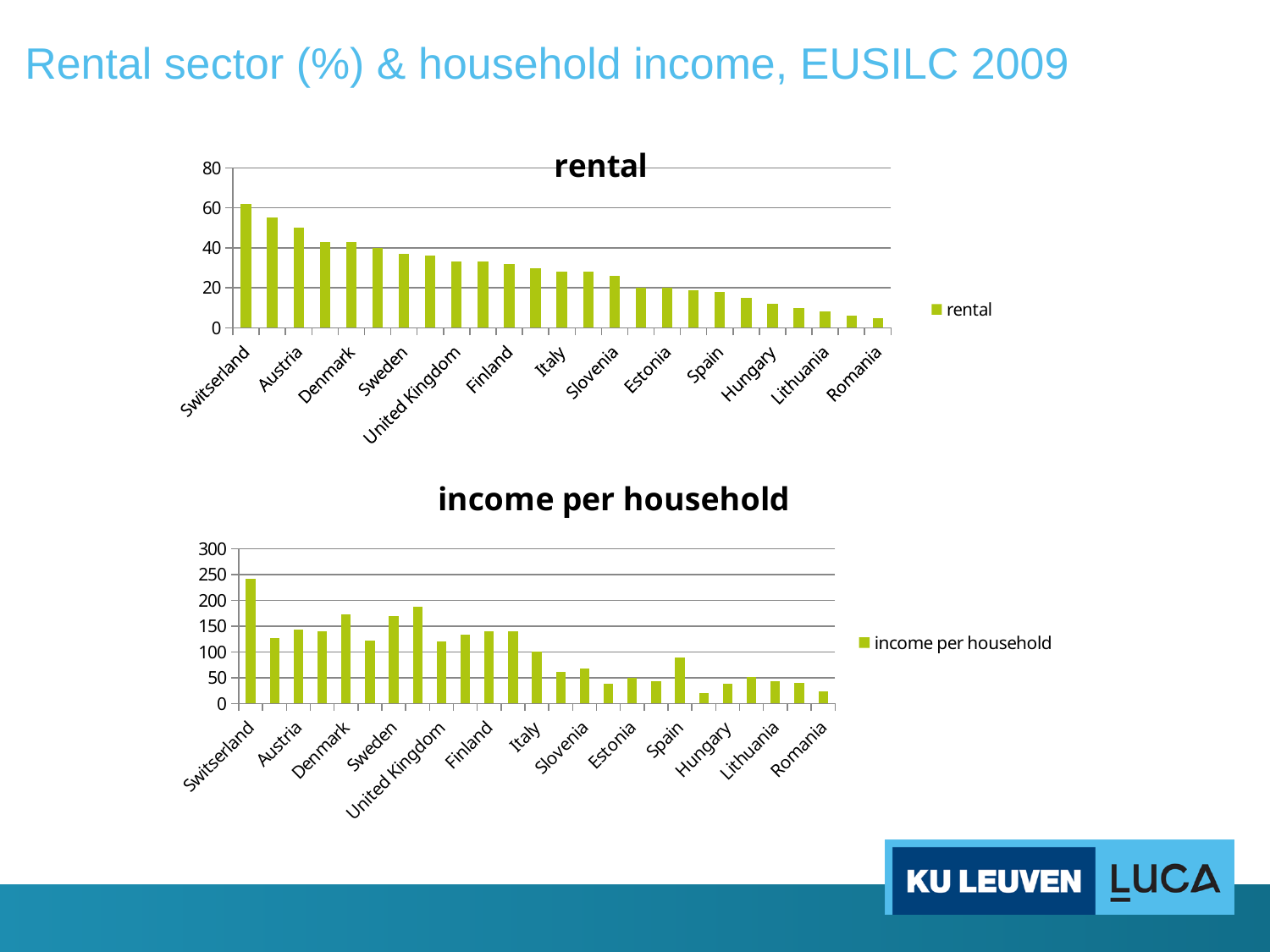
In the 'rental' chart, which country has the highest value? Switserland How many series does the legend of the 'rental' chart list? 1 In the 'income per household' chart, is the value for Hungary greater or less than 50? less In the 'rental' chart, which country has the lowest value? Romania In the 'income per household' chart, which is larger, the value for Denmark or the value for Italy? Denmark In the 'income per household' chart, is the value for Switzerland greater or less than 200? greater In the 'rental' chart, is the value for Switzerland greater or less than 40? greater In the 'income per household' chart, which country has the highest value? Switserland In the 'rental' chart, do the values rise or fall from left to right along the x axis? fall What kind of chart is the 'rental' chart? bar chart In the 'rental' chart, which is larger, the value for Austria or the value for Spain? Austria